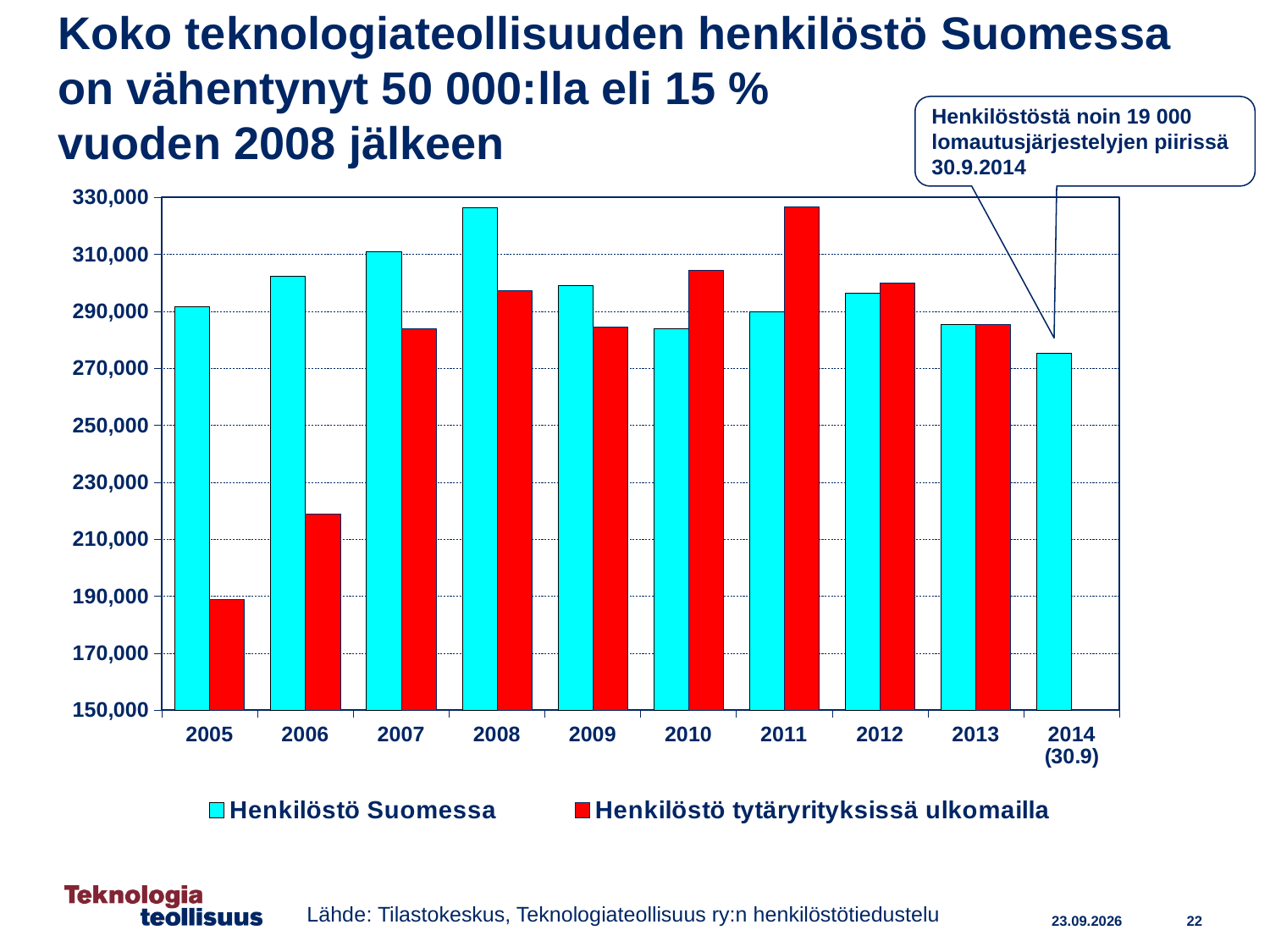
How many years (categories) are shown on the x axis? 10 Is the value for Henkilöstö Suomessa in 2008 greater or less than 310,000? greater In which year is the value for Henkilöstö Suomessa lowest? 2014 (30.9) How many series does the legend list? 2 What kind of chart is shown on the slide? bar chart In which year is the value for Henkilöstö tytäryrityksissä ulkomailla highest? 2011 Which colour represents Henkilöstö tytäryrityksissä ulkomailla in the chart? red In which year is the value for Henkilöstö Suomessa highest? 2008 In 2011, which series has the larger value: Henkilöstö Suomessa or Henkilöstö tytäryrityksissä ulkomailla? Henkilöstö tytäryrityksissä ulkomailla In which year is the value for Henkilöstö tytäryrityksissä ulkomailla lowest? 2005 Is the value for Henkilöstö tytäryrityksissä ulkomailla in 2006 greater or less than 230,000? less